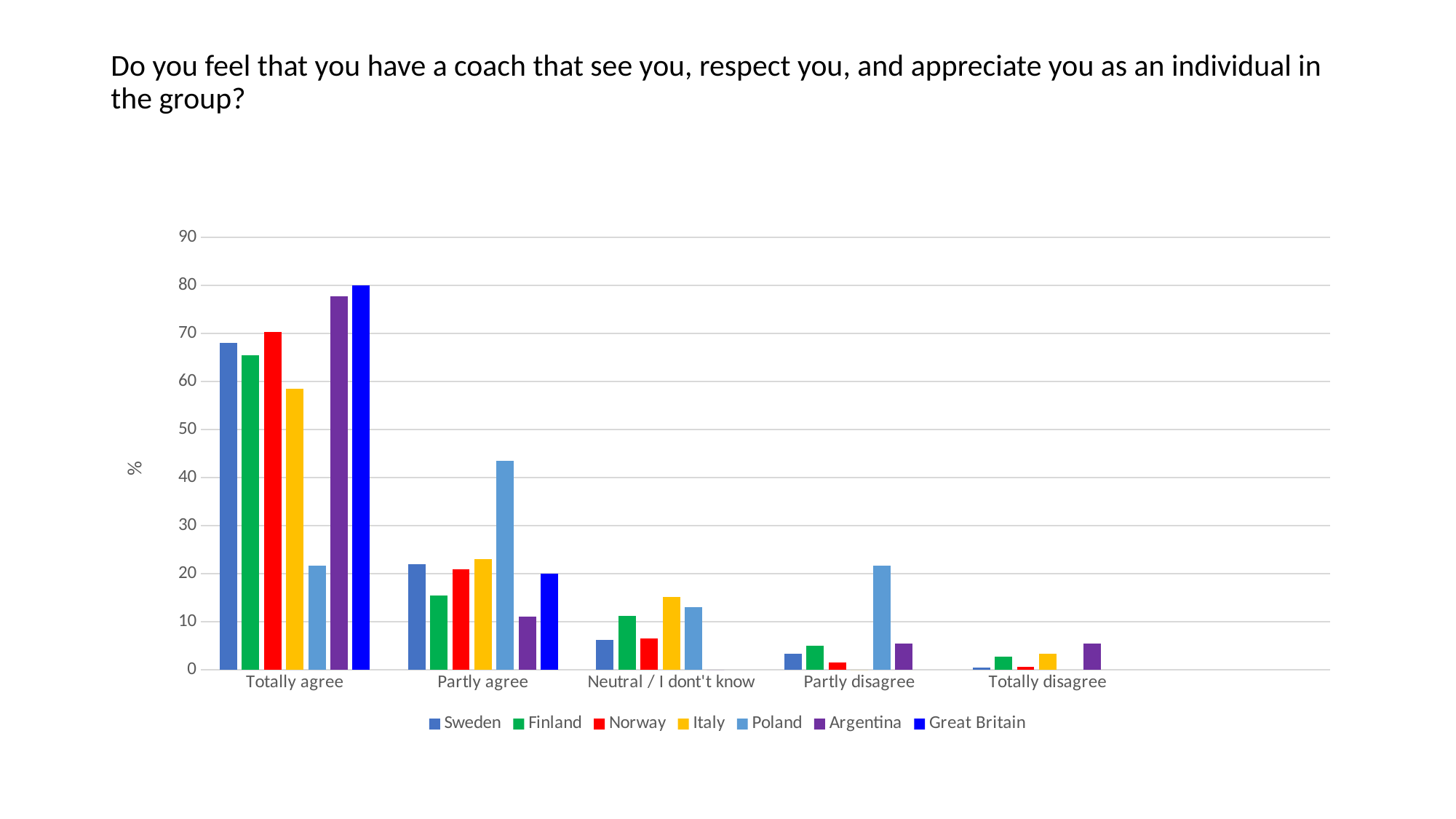
Which country has the highest value for 'Partly disagree'? Poland Which is larger for 'Totally agree': Norway or Italy? Norway Is the value for Poland in 'Totally agree' greater or less than 30? less What is the label on the y axis? % Which country has the lowest value for 'Totally agree'? Poland Which country has the highest value for 'Totally agree'? Great Britain What kind of chart is shown on the slide? bar chart Which is larger for 'Neutral / I dont't know': Italy or Sweden? Italy How many series does the legend list? 7 Which country has the highest value for 'Partly agree'? Poland How many response categories are shown on the x axis? 5 Is the value for Sweden in 'Totally agree' greater or less than 60? greater